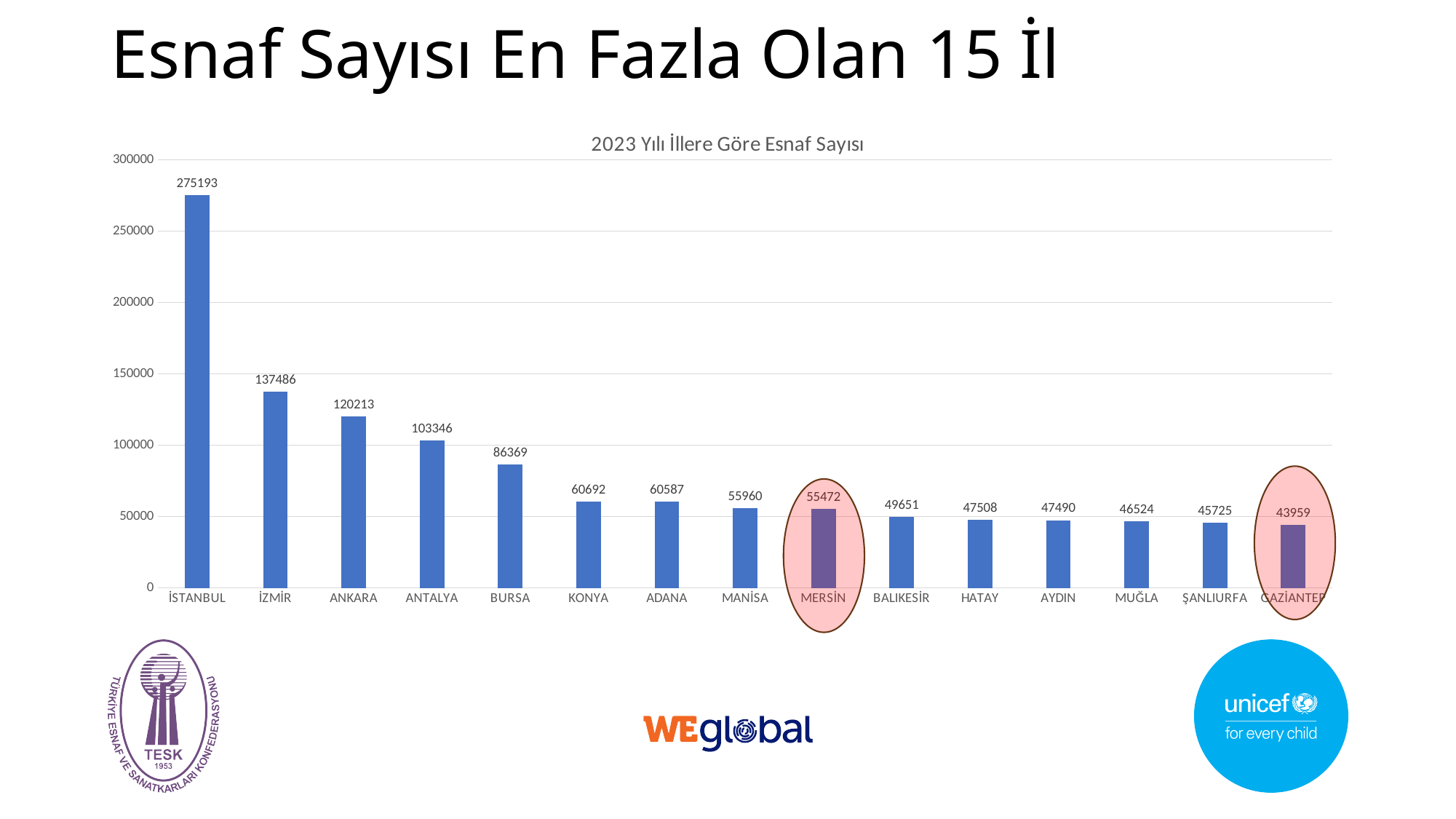
Which is larger, the value for BURSA or the value for ANTALYA? ANTALYA Which city has the lowest value? GAZİANTEP What kind of chart is shown on the slide? bar chart Is the value for KONYA greater or less than 50000? greater How many cities are shown in the chart? 15 What is the value for MERSİN? 55472 What is the difference between the values for İSTANBUL and İZMİR? 137707 Which city has the highest value? İSTANBUL What is the title of the chart? 2023 Yılı İllere Göre Esnaf Sayısı What is the difference between the values for MERSİN and GAZİANTEP? 11513 What is the value for ANKARA? 120213 What is the value for GAZİANTEP? 43959